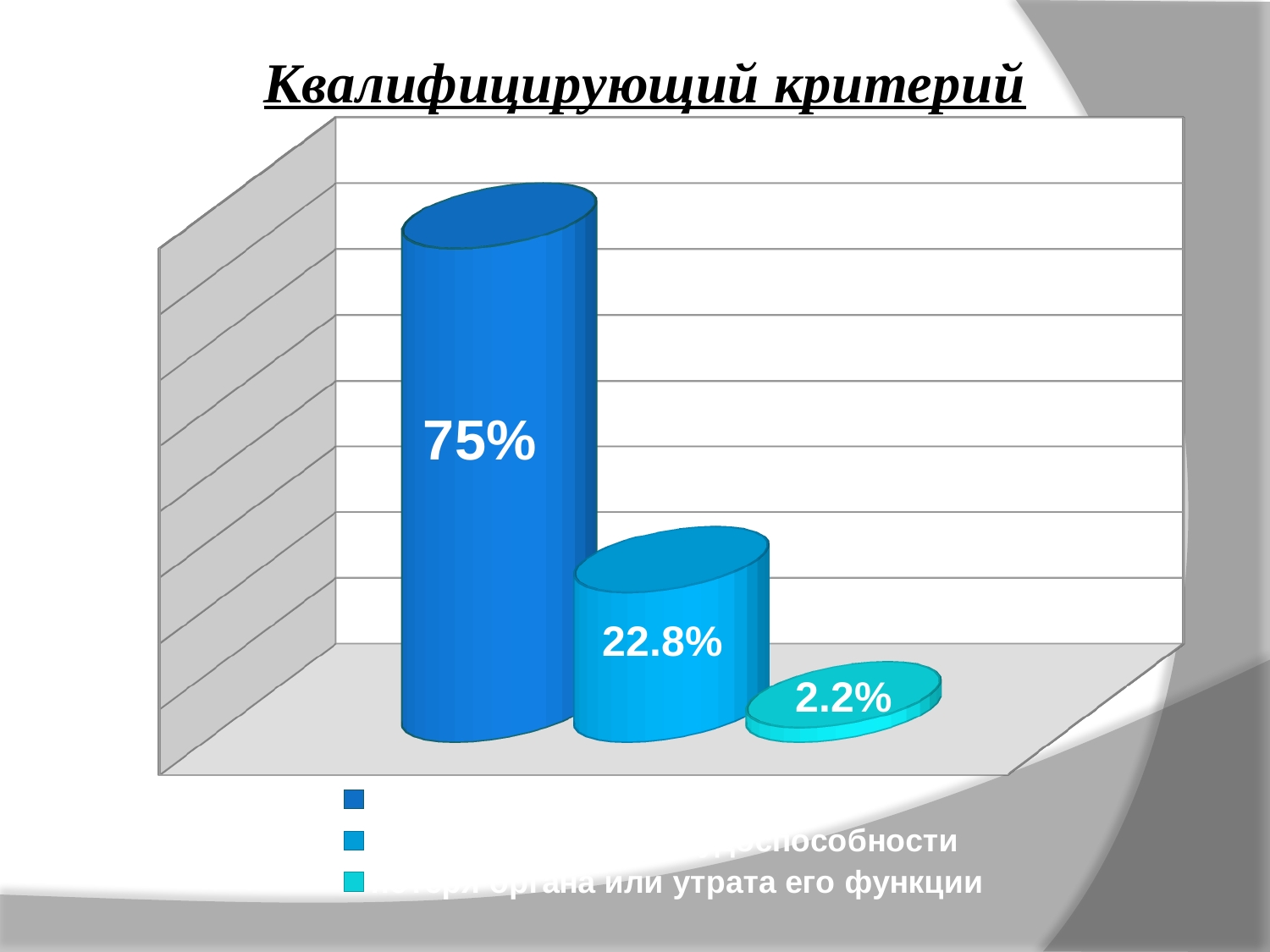
How many entries does the legend list? 3 What value is shown on the rightmost (smallest) bar? 2.2% What kind of chart is shown on the slide? Bar chart Which is larger, the middle bar or the rightmost bar? The middle bar (22.8%) What is the difference between the leftmost bar (75%) and the middle bar (22.8%)? 52.2% What is the title of the chart? Квалифицирующий критерий What is the lowest value shown in the chart? 2.2% What value is shown on the middle bar? 22.8% Do the bar values rise or fall from left to right? Fall How many bars are plotted in the chart? 3 What is the highest value shown in the chart? 75% What value is shown on the leftmost (tallest) bar? 75%